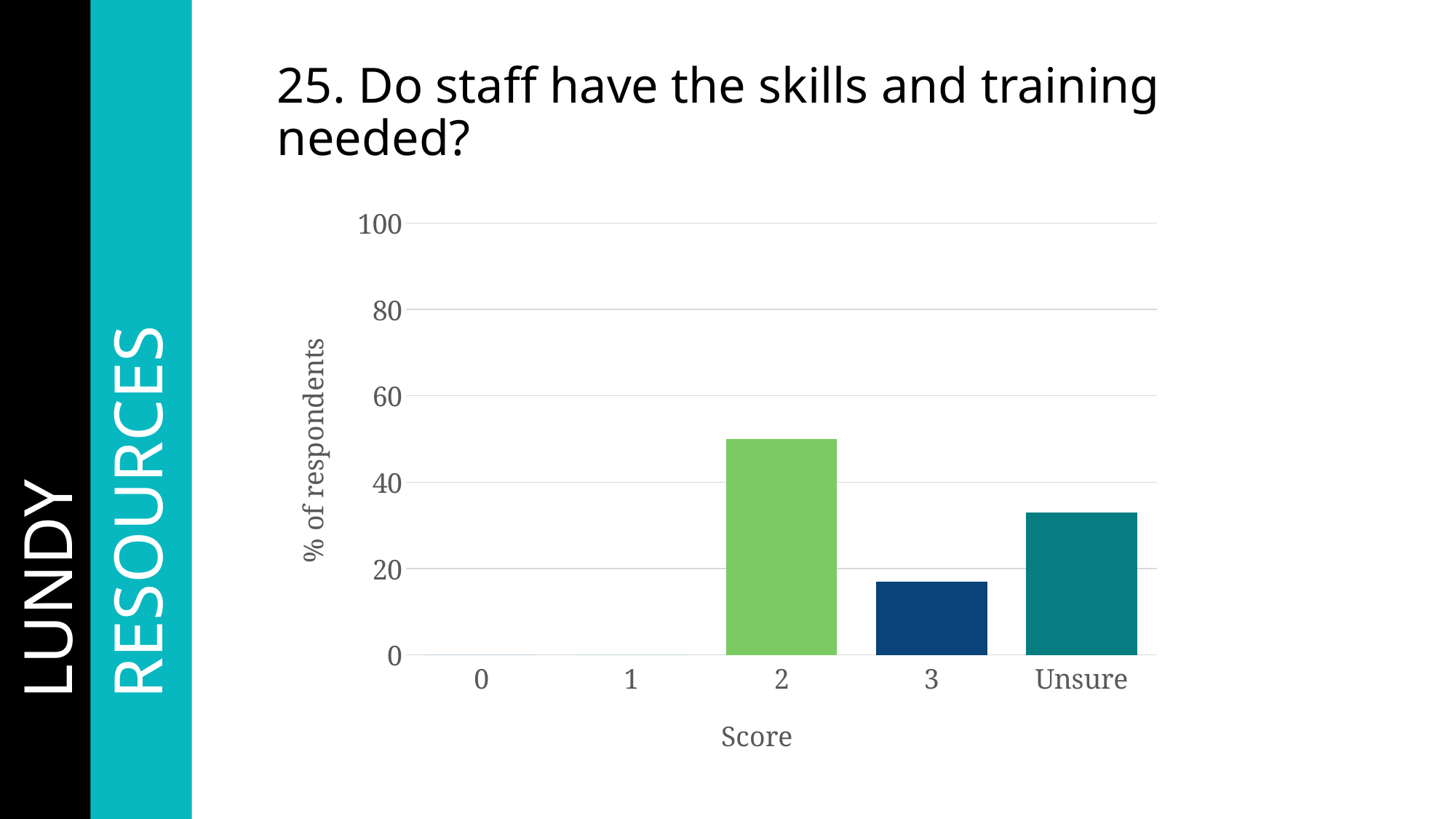
What is the label of the y axis of the chart? % of respondents Is the value for score 2 greater or less than 60? less What kind of chart is shown on the slide? bar chart Which category has the highest percentage of respondents? 2 Which has a higher percentage of respondents, score 3 or Unsure? Unsure Is the value for Unsure greater or less than 40? less Is the value for Unsure greater or less than 20? greater Which has a higher percentage of respondents, score 2 or Unsure? 2 How many categories are shown on the x axis of the chart? 5 What is the title of the chart on the slide? 25. Do staff have the skills and training needed?